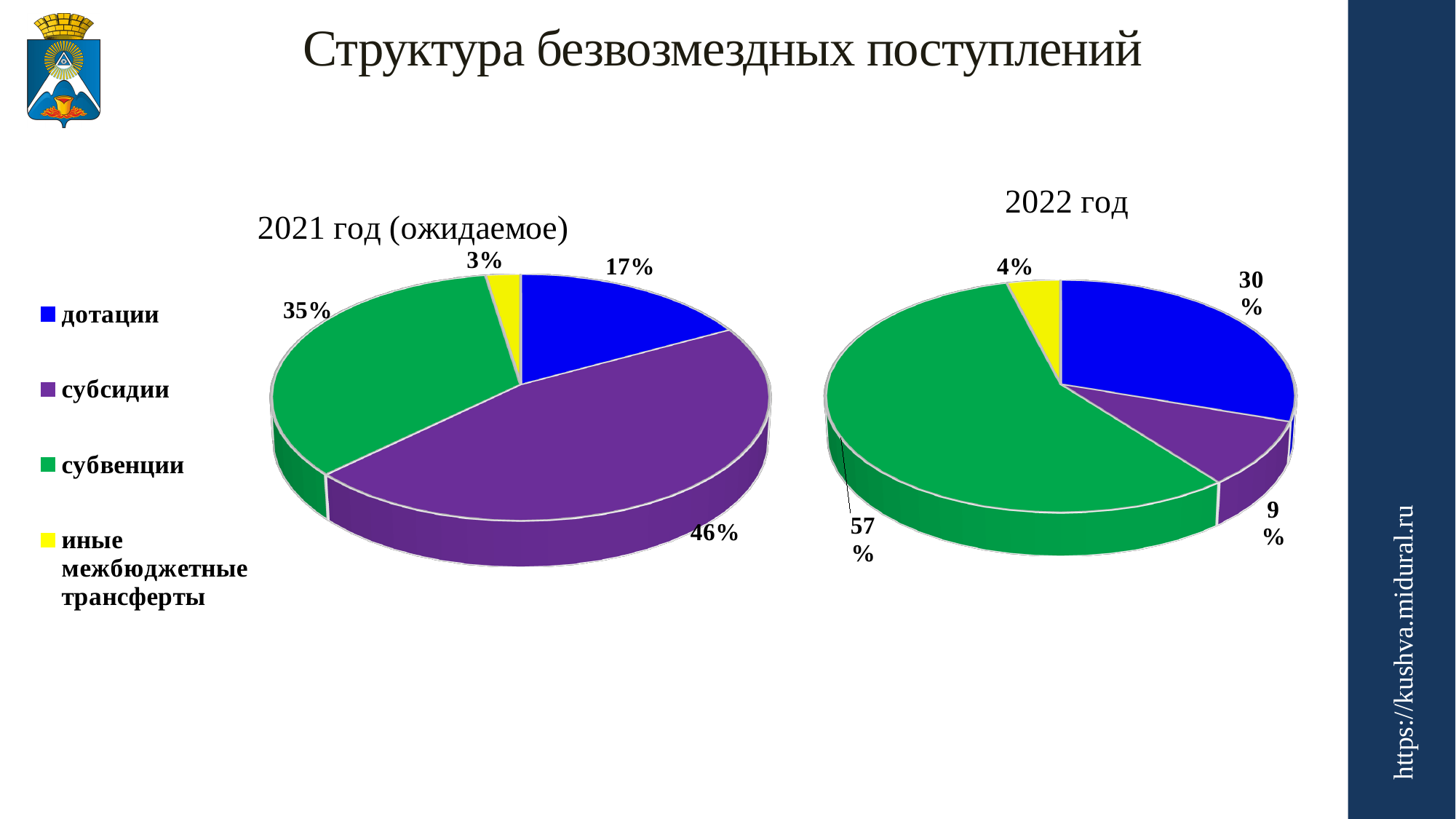
In the "2022 год" pie chart, what share is shown for иные межбюджетные трансферты? 4% In the "2021 год (ожидаемое)" pie chart, what share is shown for дотации? 17% What is the difference between the share of субвенции in the "2022 год" chart and in the "2021 год (ожидаемое)" chart? 22 percentage points Which is larger: the share of дотации in the "2021 год (ожидаемое)" chart or in the "2022 год" chart? 2022 год How many categories does the legend list for the pie charts? 4 What type of chart is used for "2022 год"? pie chart In the "2021 год (ожидаемое)" pie chart, which category has the largest share? субсидии Which colour represents субвенции in the pie charts? green In the "2022 год" pie chart, which category has the smallest share? иные межбюджетные трансферты In the "2022 год" pie chart, which category has the largest share? субвенции In the "2021 год (ожидаемое)" pie chart, what share is shown for субсидии? 46% In the "2022 год" pie chart, what share is shown for субвенции? 57%